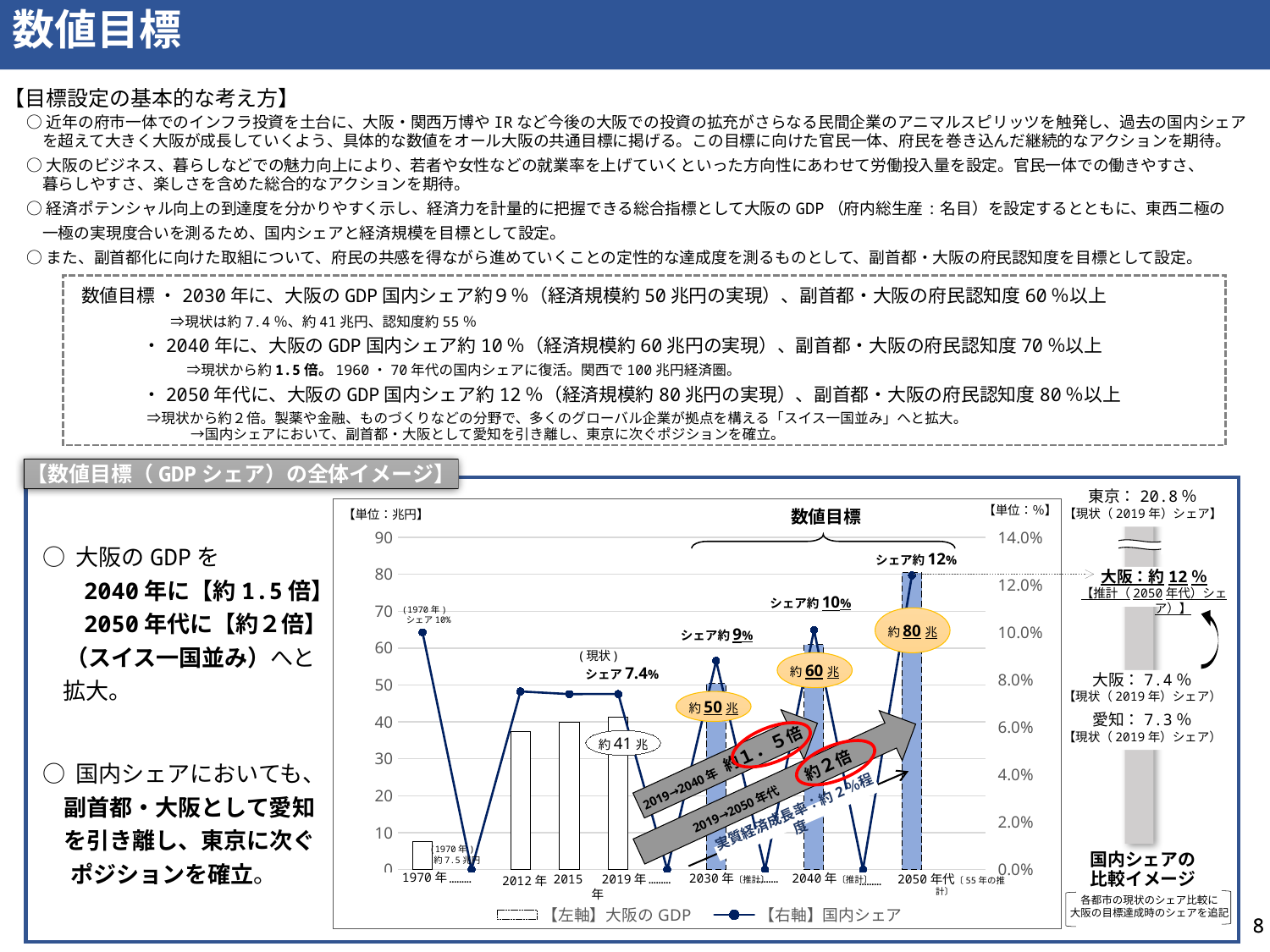
How many series does the chart legend list? 2 What is the labelled 大阪のGDP for 1970年 in the chart? 約7.5兆円 Which is larger, the 大阪のGDP for 2030年 or for 2040年? 2040年 What type of chart is shown in the 【数値目標（GDPシェア）の全体イメージ】 section? Combined bar and line chart Which year has the highest 大阪のGDP bar in the chart? 2050年代 What is the labelled value of 大阪のGDP for 2050年代 in the chart? 約80兆 Is the 大阪のGDP bar for 2012年 greater or less than 40? less What is the labelled 国内シェア for the current (現状) 2019年 point in the chart? シェア7.4% Which year has the highest 国内シェア point in the chart? 2050年代 How many year categories are shown on the x axis of the chart? 7 What is the labelled 国内シェア for 2040年 in the chart? シェア約10% What is the labelled value of 大阪のGDP for 2019年 in the chart? 約41兆